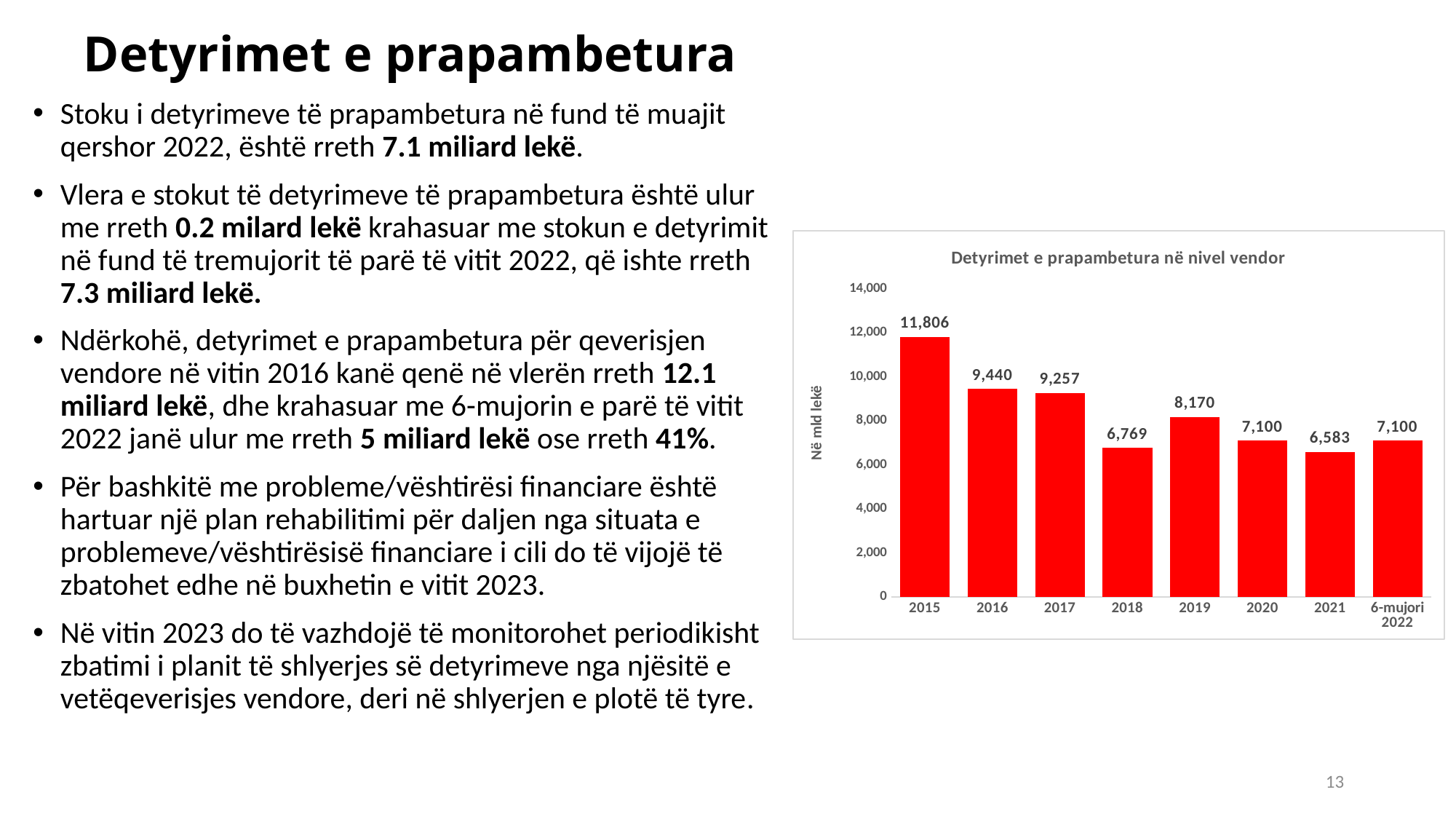
What is the value for 2019 in the chart? 8,170 What type of chart is shown on the slide? Bar chart What is the difference between the values for 2016 and 2017? 183 What is the value for 2021 in the chart? 6,583 How many bars are shown in the chart? 8 What is the title of the chart? Detyrimet e prapambetura në nivel vendor What is the difference between the values for 2015 and 2021? 5,223 What is the value for 2015 in the chart? 11,806 What is the value for 6-mujori 2022 in the chart? 7,100 Which category has the lowest value in the chart? 2021 Which is larger, the value for 2018 or the value for 2019? 2019 Which year has the highest value in the chart? 2015